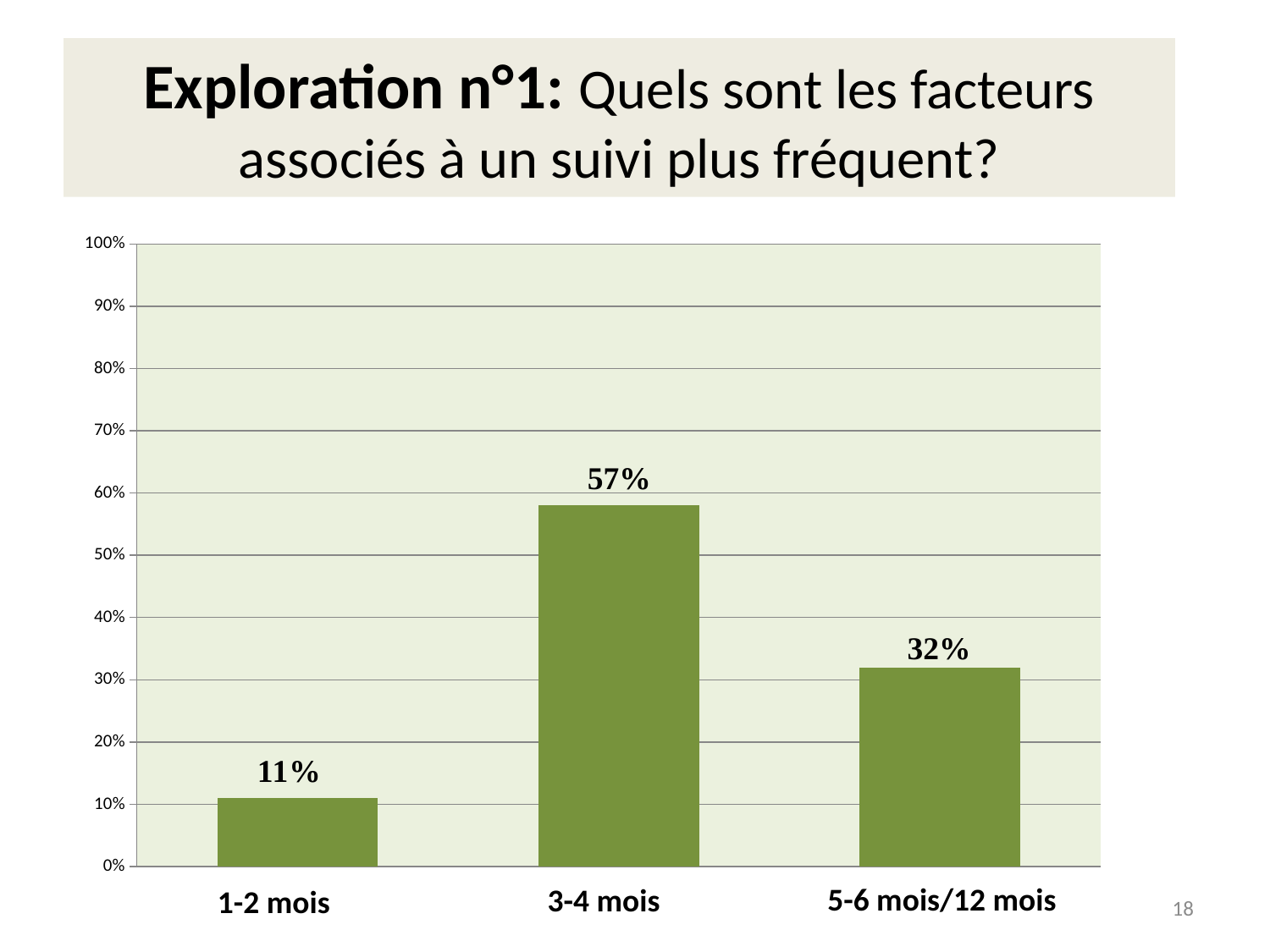
What is the difference between the values for 3-4 mois and 5-6 mois/12 mois? 25% What is the value for 3-4 mois? 57% Is the value for 3-4 mois greater or less than 50%? greater What is the value for 1-2 mois? 11% Which category has the lowest value? 1-2 mois How many categories are shown on the x axis? 3 What kind of chart is shown on the slide? bar chart What is the maximum value shown on the y axis? 100% What is the difference between the values for 5-6 mois/12 mois and 1-2 mois? 21% Which category has the highest value? 3-4 mois What is the value for 5-6 mois/12 mois? 32% Which is larger, the value for 1-2 mois or the value for 5-6 mois/12 mois? 5-6 mois/12 mois